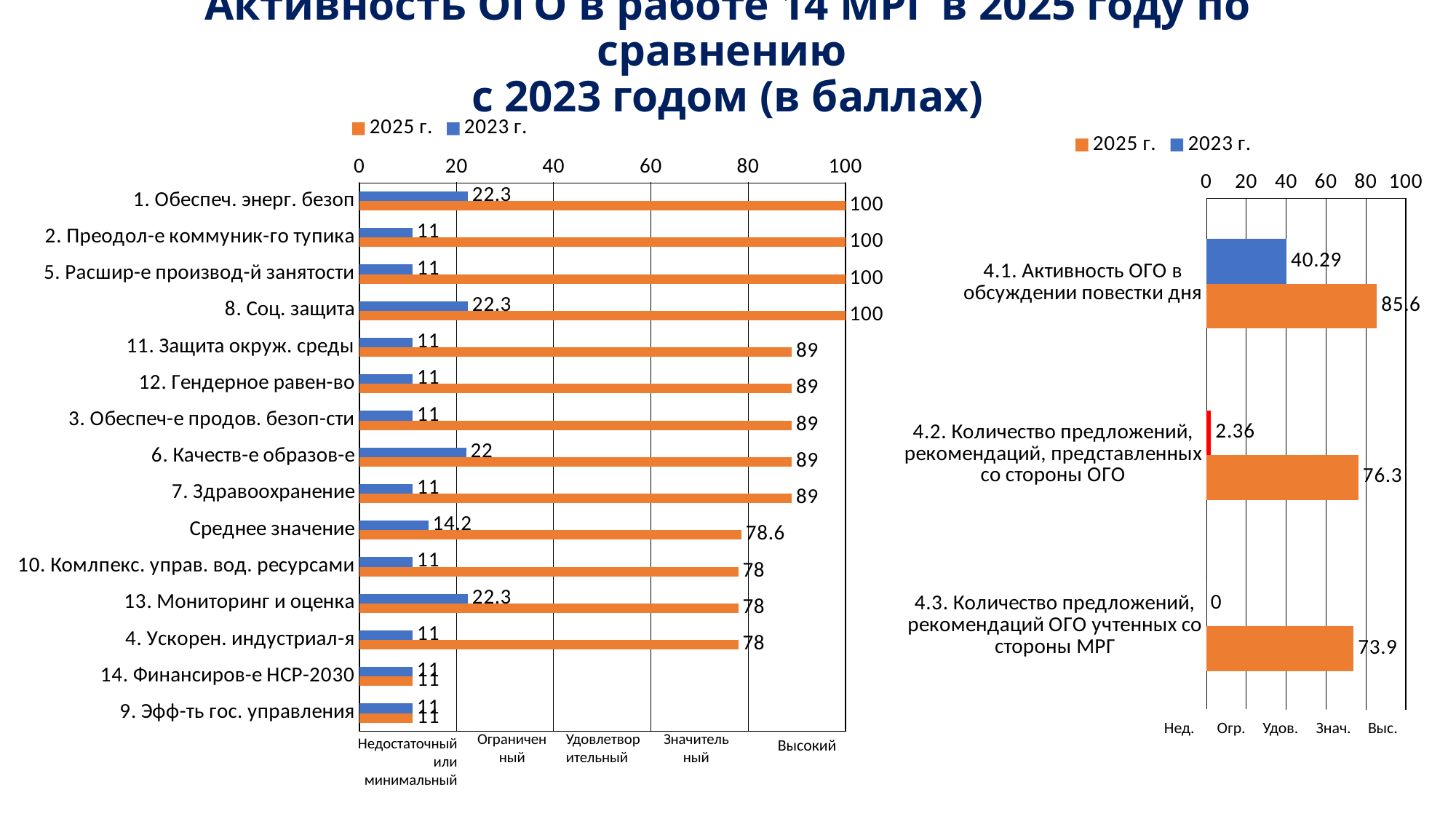
In the right chart, what is the 2025 г. value for 4.3. Количество предложений, рекомендаций ОГО учтенных со стороны МРГ? 73.9 What type of chart is the left chart? Bar chart In the left chart, what is the 2025 г. value for Среднее значение? 78.6 In the left chart, how many categories are shown on the vertical axis? 15 In the left chart, what is the 2025 г. value for 8. Соц. защита? 100 In the left chart, what is the 2023 г. value for 6. Качеств-е образов-е? 22 In the right chart, what is the 2023 г. value for 4.1. Активность ОГО в обсуждении повестки дня? 40.29 In the left chart, which category has the lowest 2025 г. value? 14. Финансиров-е НСР-2030 and 9. Эфф-ть гос. управления (both 11) In the right chart, what is the difference between the 2025 г. and 2023 г. values for 4.2. Количество предложений, рекомендаций, представленных со стороны ОГО? 73.94 How many series does the legend of the right chart list? 2 In the left chart, what is the difference between the 2025 г. and 2023 г. values for 13. Мониторинг и оценка? 55.7 In the right chart, which category has the highest 2025 г. value? 4.1. Активность ОГО в обсуждении повестки дня